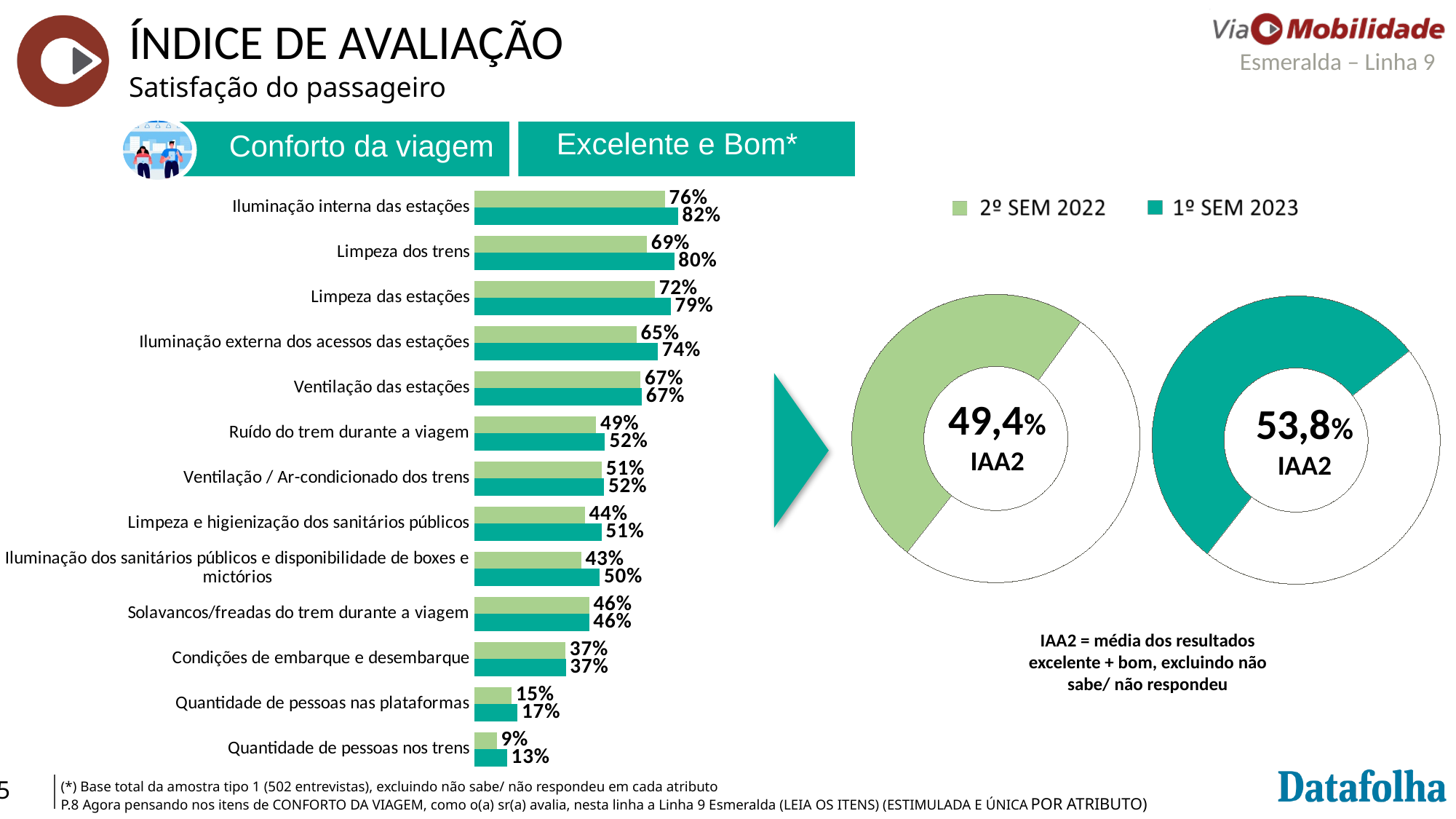
In the donut chart for 1º SEM 2023, what is the IAA2 value? 53,8% In the bar chart, which category has the highest value for 1º SEM 2023? Iluminação interna das estações In the bar chart, what is the value for 'Ruído do trem durante a viagem' in 2º SEM 2022? 49% In the donut chart for 2º SEM 2022, what is the IAA2 value? 49,4% How many series does the legend list? 2 Which series is shown in light green in the legend? 2º SEM 2022 In the bar chart, which category has the lowest value for 2º SEM 2022? Quantidade de pessoas nos trens In the bar chart, which is larger for 'Iluminação externa dos acessos das estações': the 2º SEM 2022 value or the 1º SEM 2023 value? 1º SEM 2023 How many categories does the bar chart show? 13 In the bar chart, what is the value for 'Limpeza dos trens' in 1º SEM 2023? 80% In the bar chart, what is the difference between the 1º SEM 2023 and 2º SEM 2022 values for 'Limpeza dos trens'? 11% What kind of chart is used to show the 'Conforto da viagem' results on the left? Bar chart